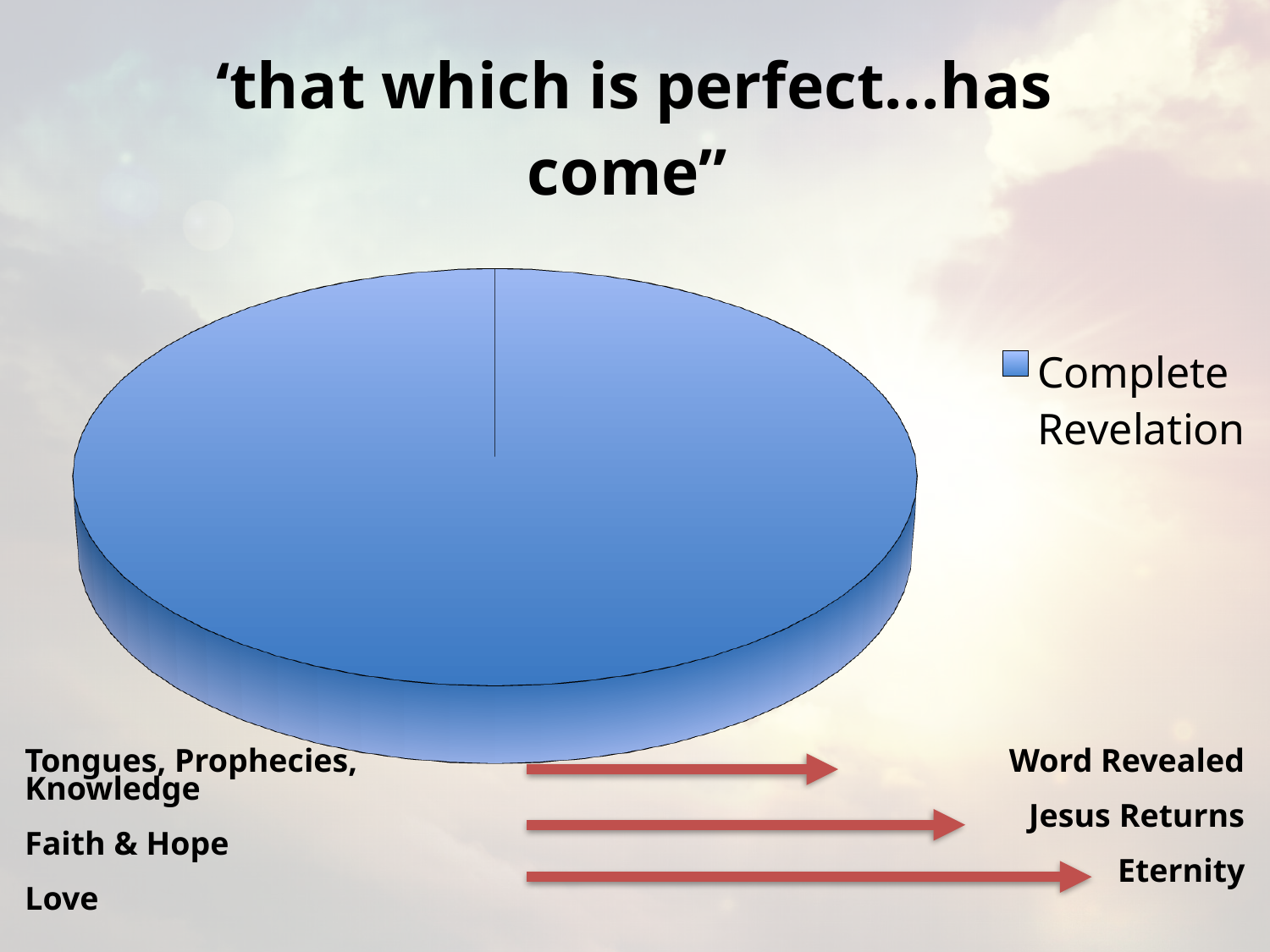
What colour is the Complete Revelation slice in the pie chart? blue What is the name of the only category shown in the pie chart's legend? Complete Revelation What kind of chart is shown on the slide? pie chart What share of the pie does the Complete Revelation slice take up? 100% How many entries does the chart's legend list? 1 How many slices does the pie chart have? 1